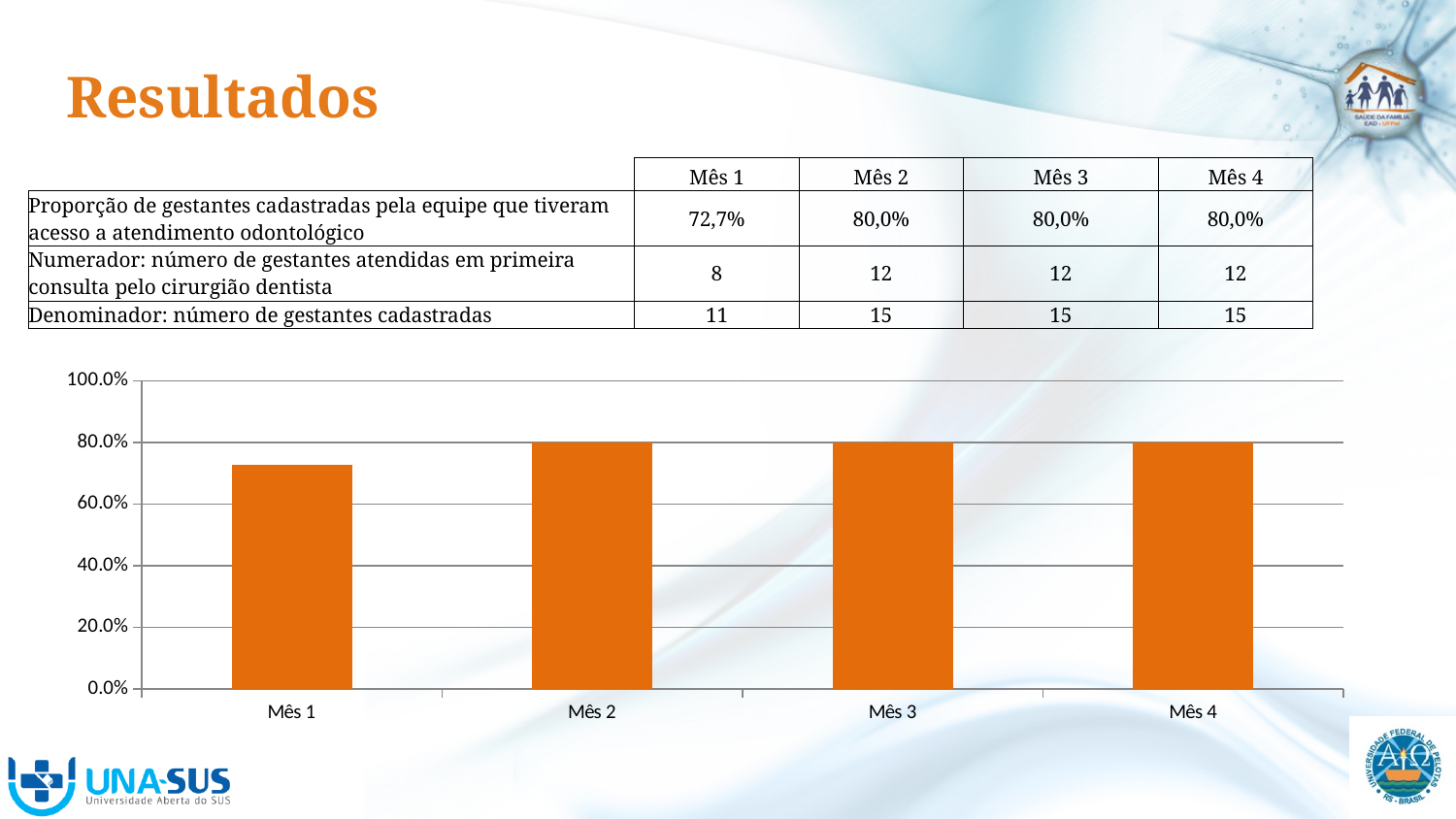
How do the values change from Mês 1 to Mês 4 in the chart? They rise from Mês 1 to Mês 2 and then stay flat According to the table, what is the proportion of registered pregnant women with access to dental care in Mês 1? 72,7% What kind of chart is shown on the slide? bar chart What is the highest value shown on the chart's y axis? 100.0% How many months (categories) are plotted on the x axis of the chart? 4 Which is larger, the bar for Mês 1 or the bar for Mês 3? Mês 3 Is the value for Mês 1 greater or less than 60.0%? greater According to the table, what is the numerator (number of pregnant women seen in first consultation by the dentist) for Mês 1? 8 Which month has the lowest bar in the chart? Mês 1 Is the value for Mês 1 greater or less than 80.0%? less According to the table, what is the denominator (number of registered pregnant women) for Mês 4? 15 What value does the bar for Mês 2 reach on the chart? 80.0%